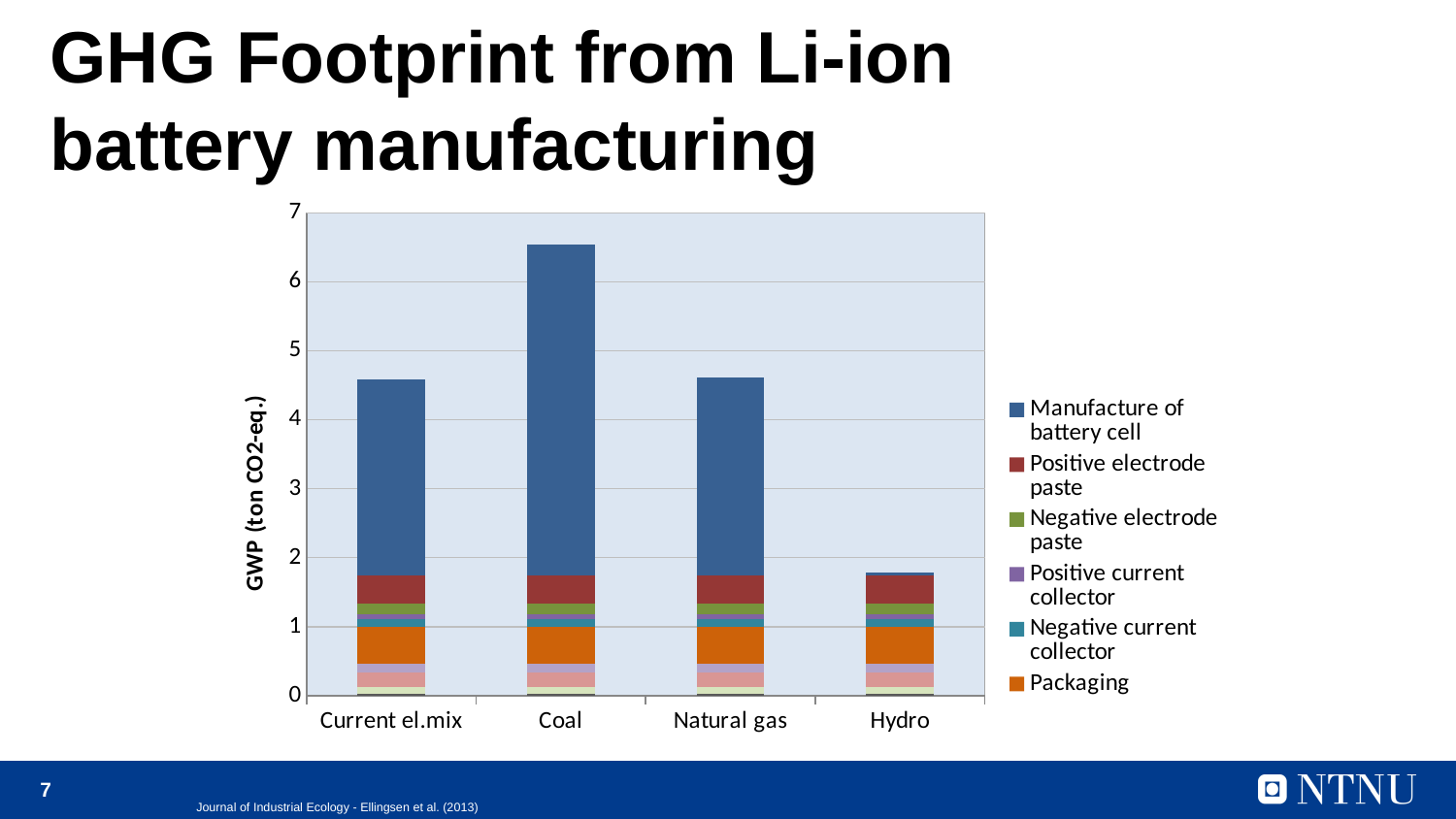
How many categories are shown on the x axis of the chart? 4 Which series is shown in dark blue at the top of each bar? Manufacture of battery cell What kind of chart is shown on the slide? Stacked bar chart Is the total value for Natural gas greater or less than 5? less Is the total value for Hydro greater or less than 2? less Which category has the lowest total GWP? Hydro Which category has the highest total GWP? Coal What is the label of the y axis? GWP (ton CO2-eq.) Which has a larger total GWP, Coal or Hydro? Coal How many series does the chart's legend list? 6 Is the total value for Current el.mix greater or less than 4? greater